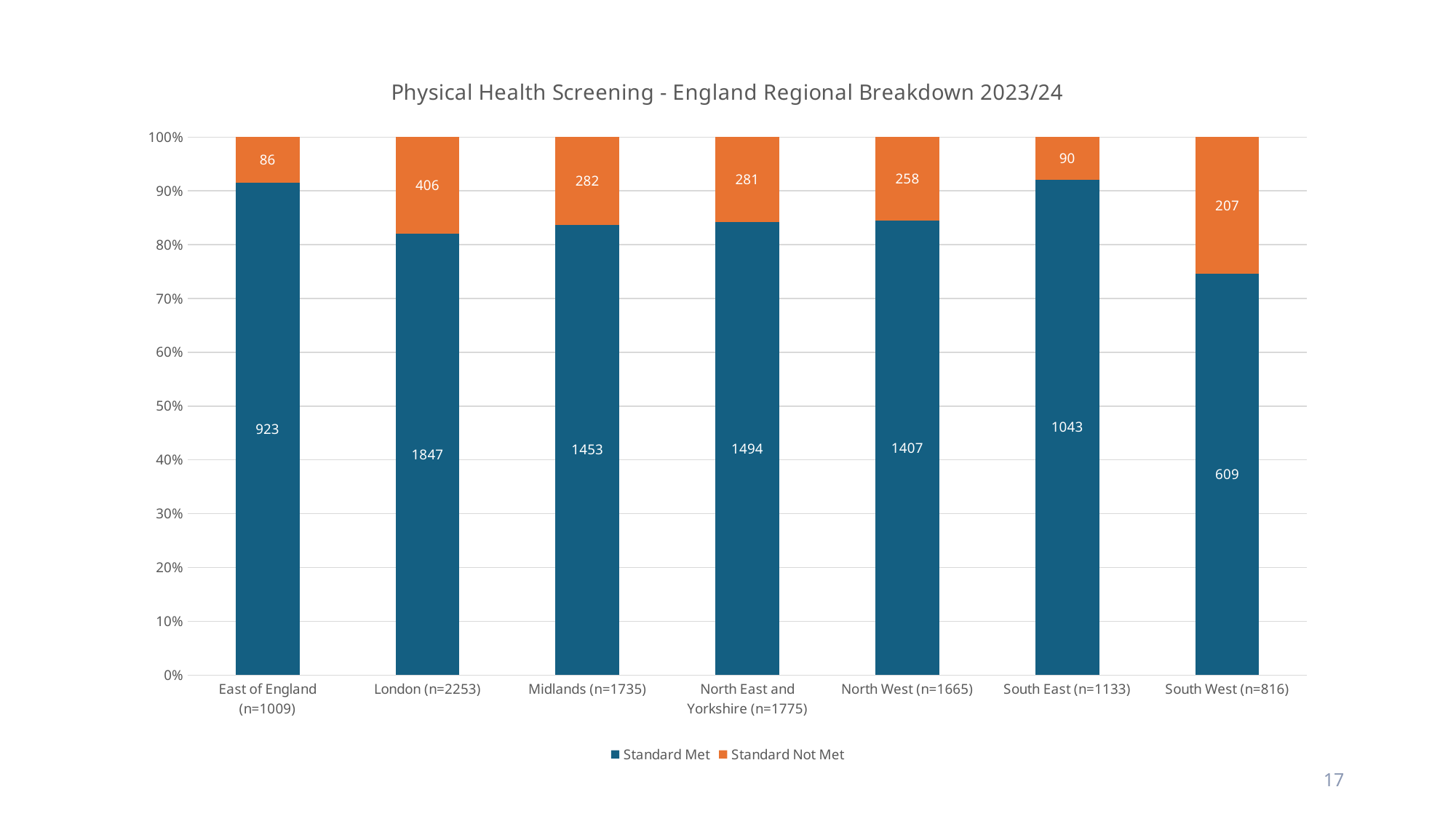
What is the Standard Met value for London (n=2253)? 1847 What is the Standard Not Met value for South West (n=816)? 207 Which region has the lowest Standard Not Met count? East of England (n=1009) Which is larger, the Standard Met value for Midlands (n=1735) or for North West (n=1665)? Midlands (n=1735) How many series does the legend list? 2 How many regions are shown on the x axis? 7 Is the Standard Met share for South West (n=816) greater or less than 80%? less What is the difference between the Standard Not Met values for London (n=2253) and East of England (n=1009)? 320 What type of chart is shown on the slide? Stacked bar chart Is the Standard Met share for East of England (n=1009) greater or less than 90%? greater Which region has the highest Standard Met count? London (n=2253) What is the Standard Met value for North East and Yorkshire (n=1775)? 1494